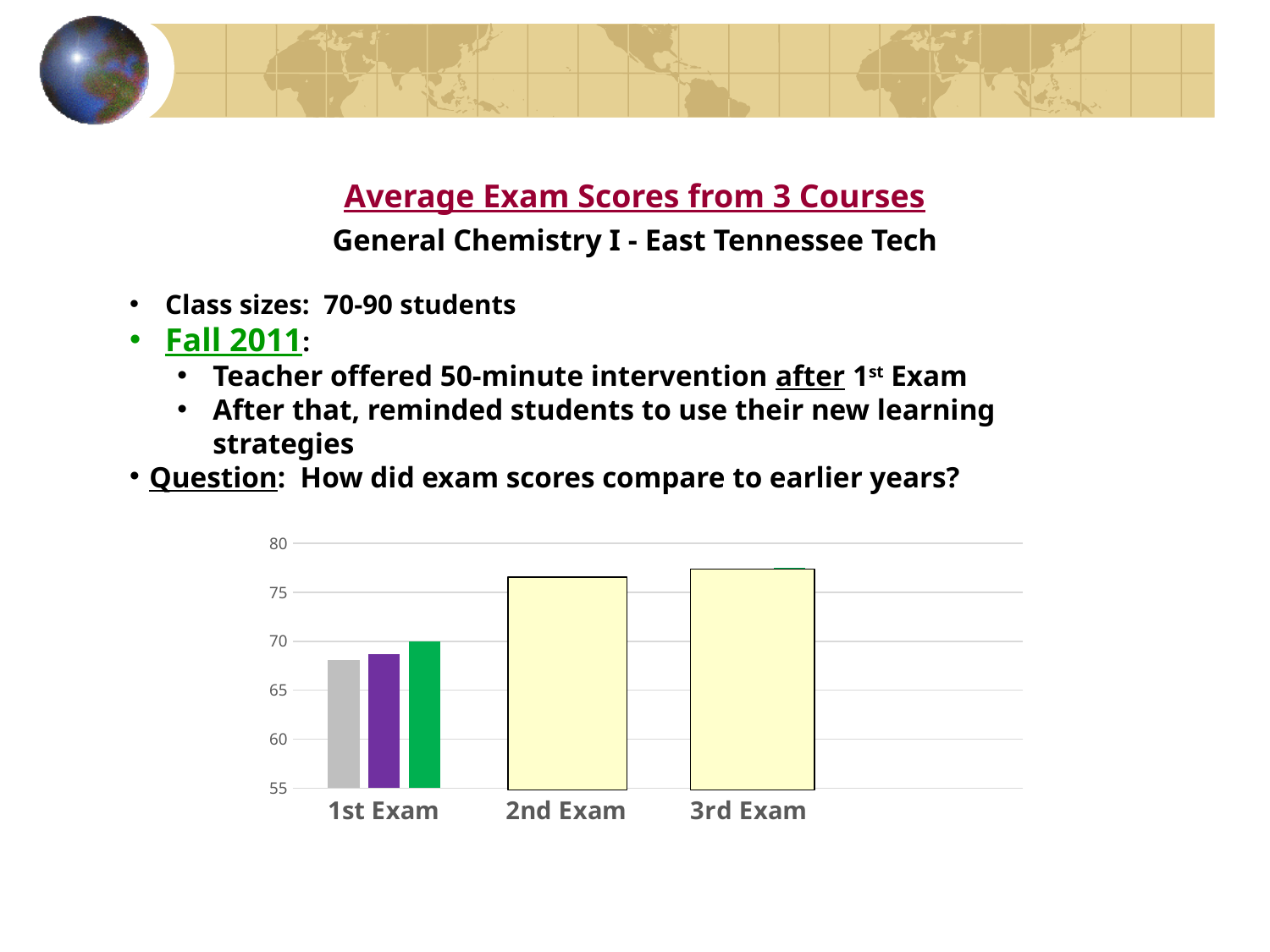
What is the lowest value shown on the chart's vertical axis? 55 Is the value of the bar for the 2nd Exam greater or less than 75? greater Which is larger: the bar for the 2nd Exam or the gray bar for the 1st Exam? 2nd Exam Is the value of the purple bar for the 1st Exam greater or less than 65? greater How many bars are plotted for the 1st Exam category? 3 How many bars are plotted in total on the chart? 5 Is the value of the gray bar for the 1st Exam greater or less than 70? less What kind of chart is shown on the slide? bar chart How many exam categories are shown on the x axis of the chart? 3 Do the bar heights generally rise or fall from the 1st Exam to the 3rd Exam? rise